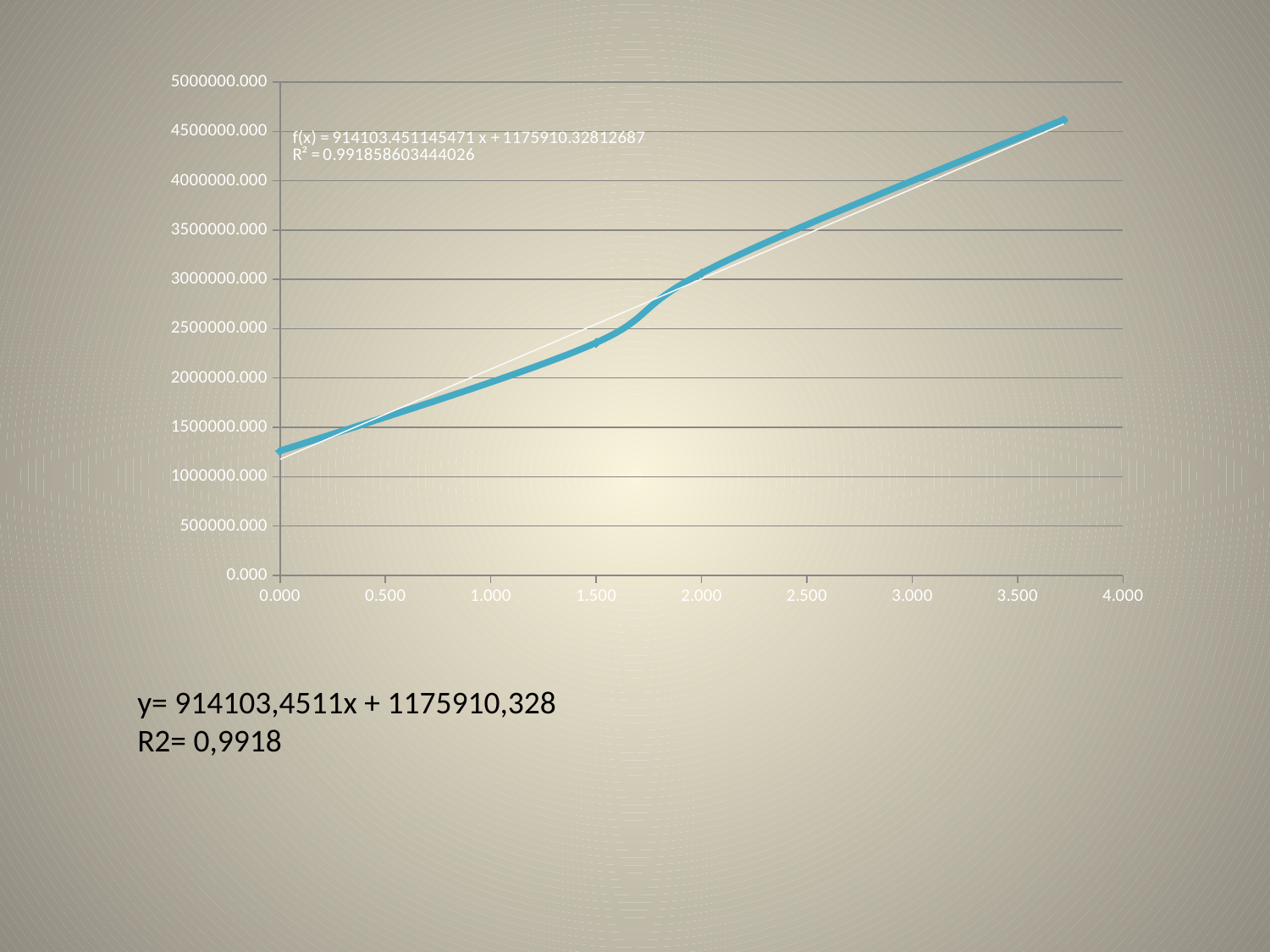
What R² value is printed on the chart next to the trendline equation? 0.991858603444026 Is the plotted value at x = 1.000 greater or less than 2500000.000? less Is the plotted value at x = 3.000 greater or less than 3500000.000? greater What is the highest value shown on the y axis? 5000000.000 Is the plotted value at x = 0.500 greater or less than 2000000.000? less Do the plotted values rise or fall as x increases from 0.000 to 4.000? rise What kind of chart is shown on the slide? line chart